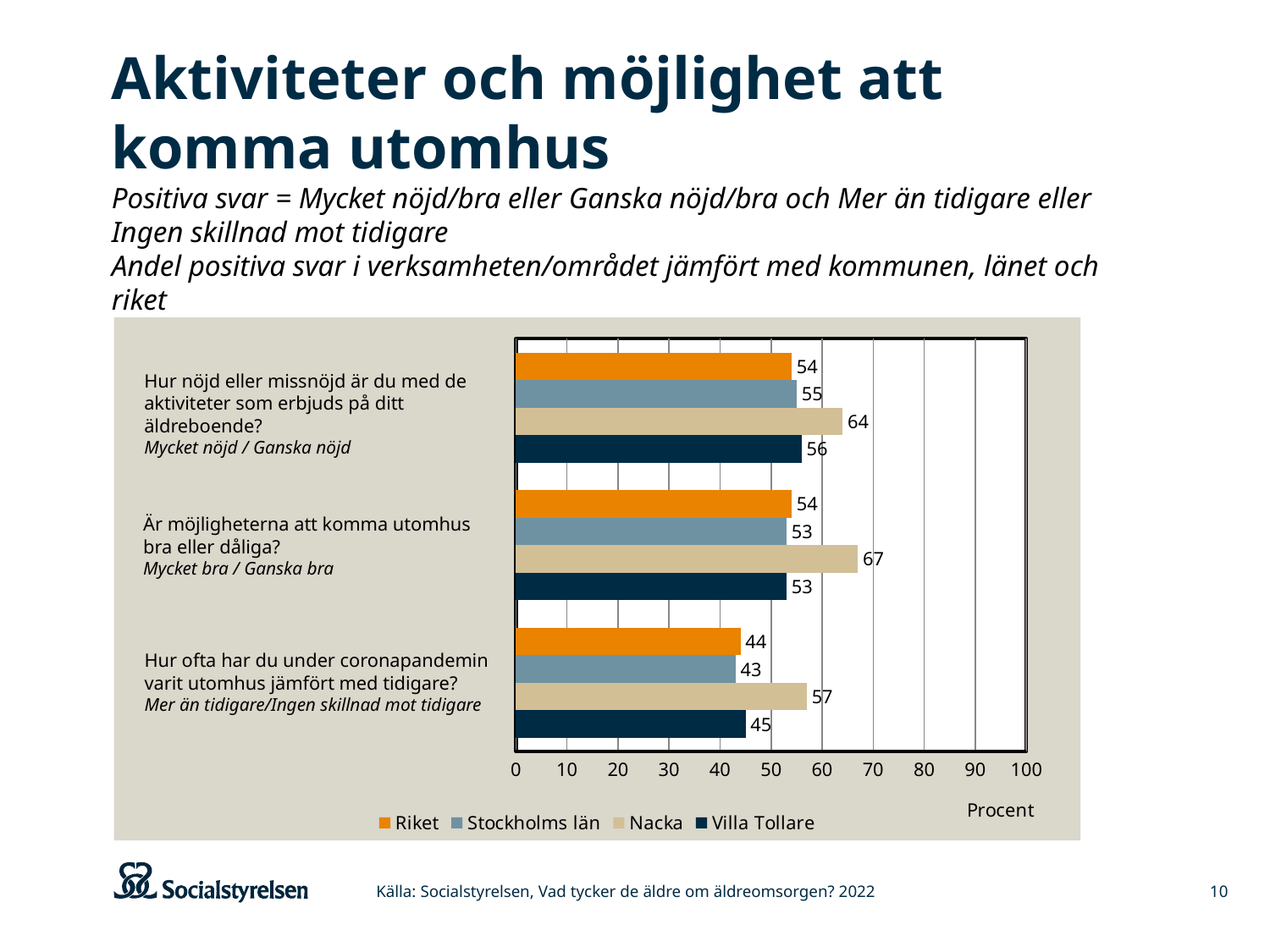
What unit is shown on the horizontal axis of the chart? Procent How many question categories are shown on the chart? 3 What is the value for Nacka on the question "Är möjligheterna att komma utomhus bra eller dåliga?"? 67 What is the value for Stockholms län on the question "Hur ofta har du under coronapandemin varit utomhus jämfört med tidigare?"? 43 Which series has the lowest value on the question "Hur nöjd eller missnöjd är du med de aktiviteter som erbjuds på ditt äldreboende?"? Riket What is the difference between Nacka and Villa Tollare on the question "Hur ofta har du under coronapandemin varit utomhus jämfört med tidigare?"? 12 What kind of chart is shown on the slide? Bar chart What is the value for Villa Tollare on the question "Hur nöjd eller missnöjd är du med de aktiviteter som erbjuds på ditt äldreboende?"? 56 Which is larger on the question "Hur nöjd eller missnöjd är du med de aktiviteter som erbjuds på ditt äldreboende?": Villa Tollare or Stockholms län? Villa Tollare What is the difference between Nacka and Riket on the question "Är möjligheterna att komma utomhus bra eller dåliga?"? 13 Which series has the highest value on the question "Hur ofta har du under coronapandemin varit utomhus jämfört med tidigare?"? Nacka How many series does the legend list? 4